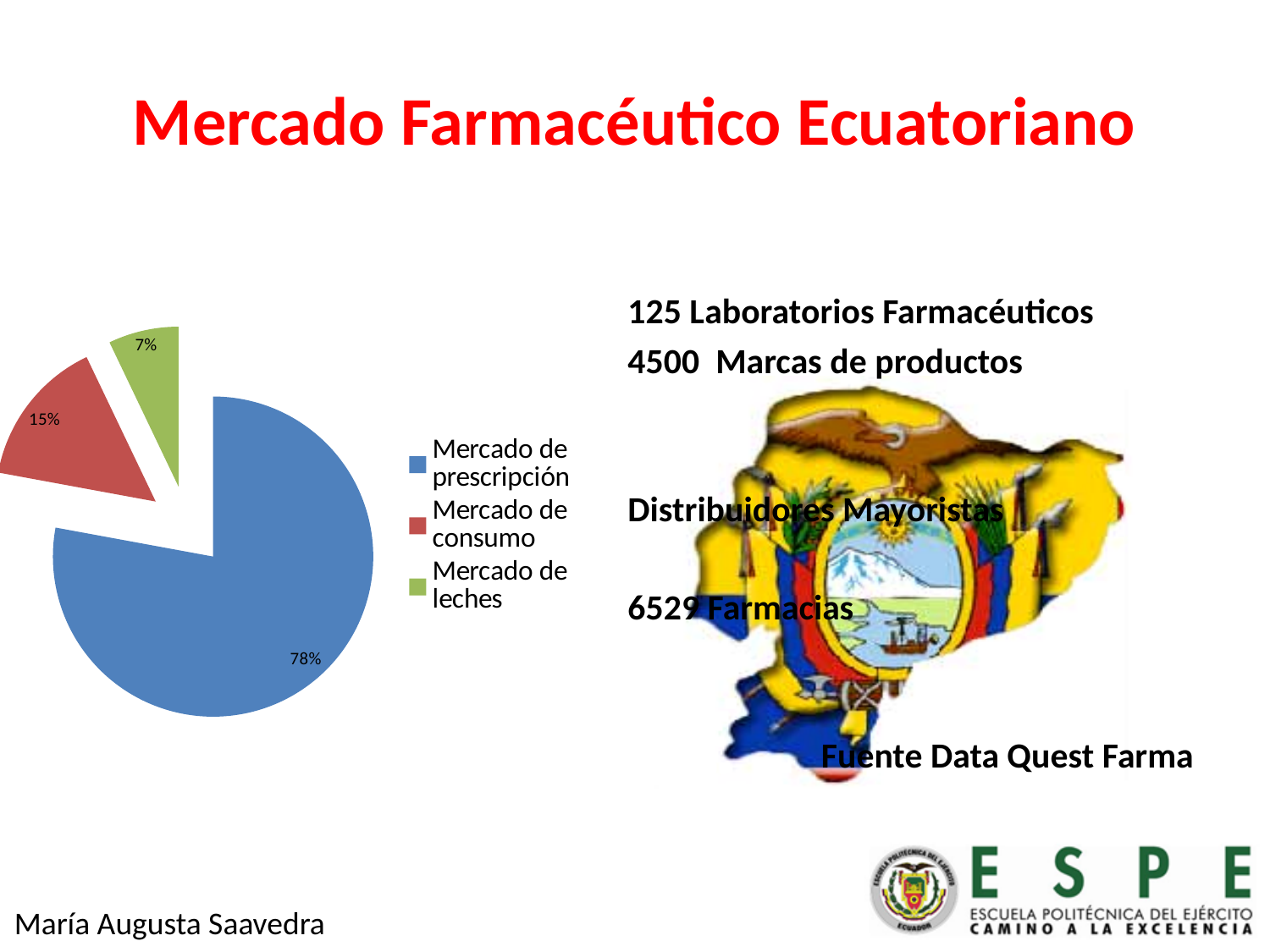
Which is larger, Mercado de consumo or Mercado de leches? Mercado de consumo What share of the pie does Mercado de leches have? 7% Which category has the smallest slice of the pie? Mercado de leches Which category has the largest slice of the pie? Mercado de prescripción What is the difference in percentage points between Mercado de consumo and Mercado de leches? 8 What share of the pie does Mercado de prescripción have? 78% What kind of chart is shown on the slide? Pie chart How many categories does the pie chart have? 3 How many entries does the legend list? 3 What share of the pie does Mercado de consumo have? 15% What is the difference in percentage points between Mercado de prescripción and Mercado de consumo? 63 What colour is the slice for Mercado de leches? Green